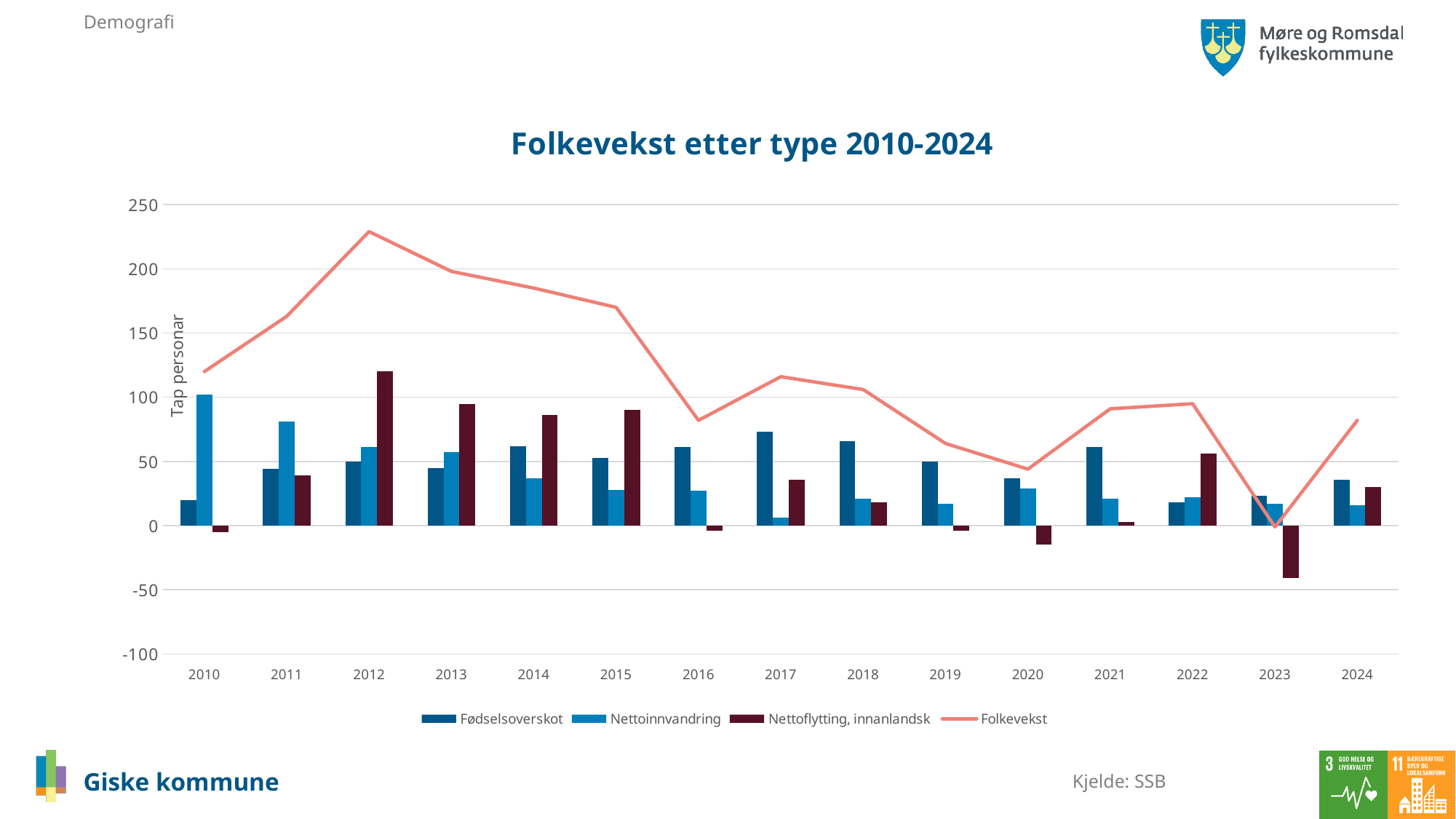
How many series does the legend list? 4 What kind of chart is shown on the slide? A combination bar and line chart In which year is the Nettoflytting, innanlandsk bar lowest? 2023 In 2010, which is larger: Nettoinnvandring or Fødselsoverskot? Nettoinnvandring Is the Folkevekst value for 2012 greater or less than 200? greater In which year does the Folkevekst line reach its lowest value? 2023 Is the Nettoflytting, innanlandsk value for 2012 greater or less than 100? greater In which year is the Nettoinnvandring bar highest? 2010 In which year is the Fødselsoverskot bar highest? 2017 In which year does the Folkevekst line reach its highest value? 2012 What is the label on the vertical axis? Tap personar How many years are shown on the x axis? 15